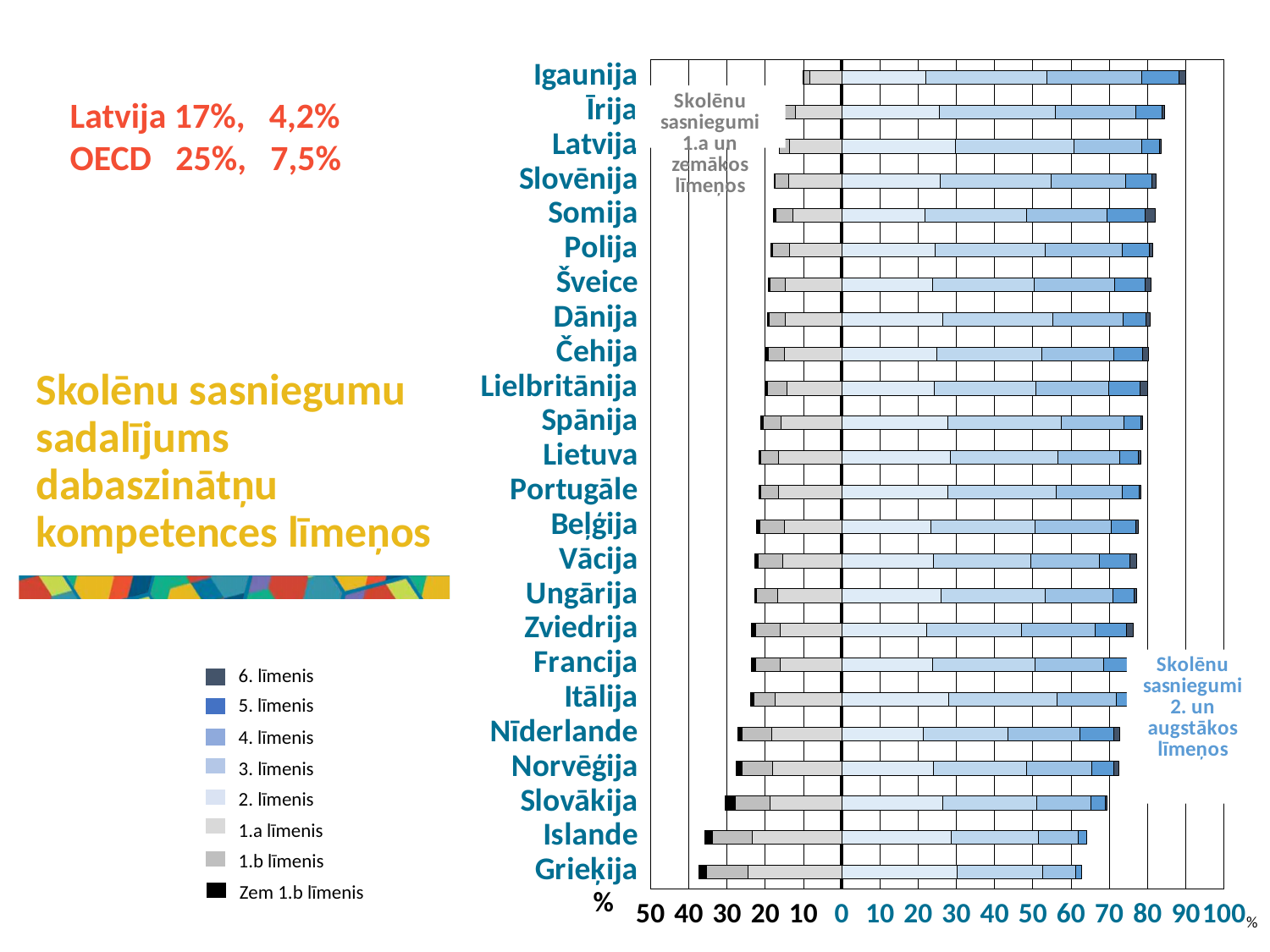
How many levels does the legend list? 8 Is the right-side bar for Igaunija greater or less than 80? greater Which country is listed first at the top of the chart? Igaunija Which legend entry is listed last, at the bottom of the legend? Zem 1.b līmenis What kind of chart is shown on the slide? bar chart Which country has the shortest bar on the right side (levels 2 and above)? Grieķija Is the right-side bar for Grieķija greater or less than 70? less How many countries are listed on the chart? 24 Which country has the longest bar on the right side (levels 2 and above)? Igaunija Is the left-side bar for Latvija greater or less than 20? less Which has a longer right-side bar, Igaunija or Grieķija? Igaunija